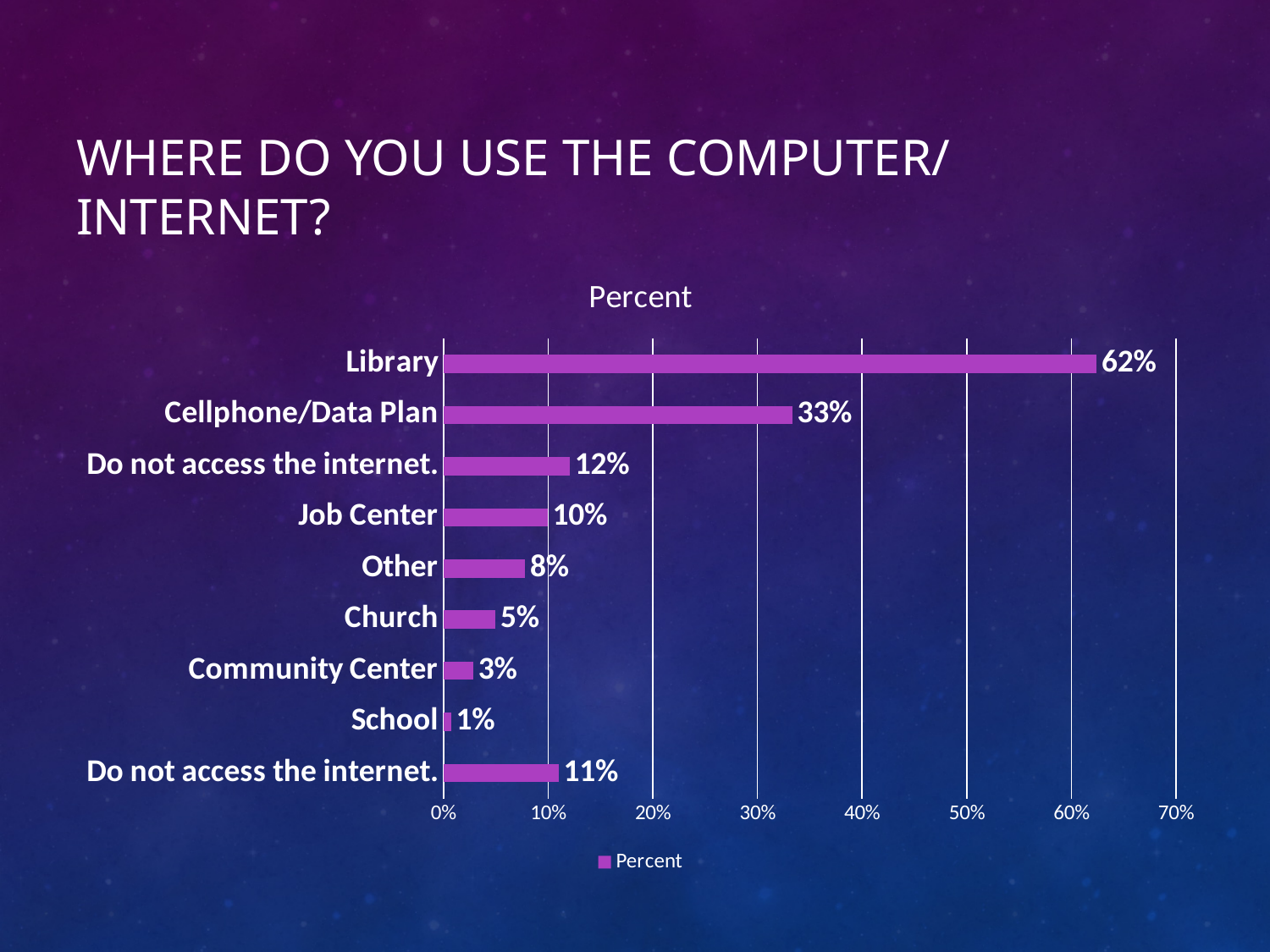
Which category has the lowest value? School What is the value for Cellphone/Data Plan? 33% Is the value for Other greater or less than 10%? less What is the difference between the values for Library and Cellphone/Data Plan? 29% What is the value for the bottom bar, labelled 'Do not access the internet.'? 11% Which category has the highest value? Library What is the value for Job Center? 10% What is the value for Library? 62% How many bars are shown in the chart? 9 What kind of chart is shown on the slide? Bar chart Which is larger, the value for Church or the value for Community Center? Church What is the title of the chart? Percent